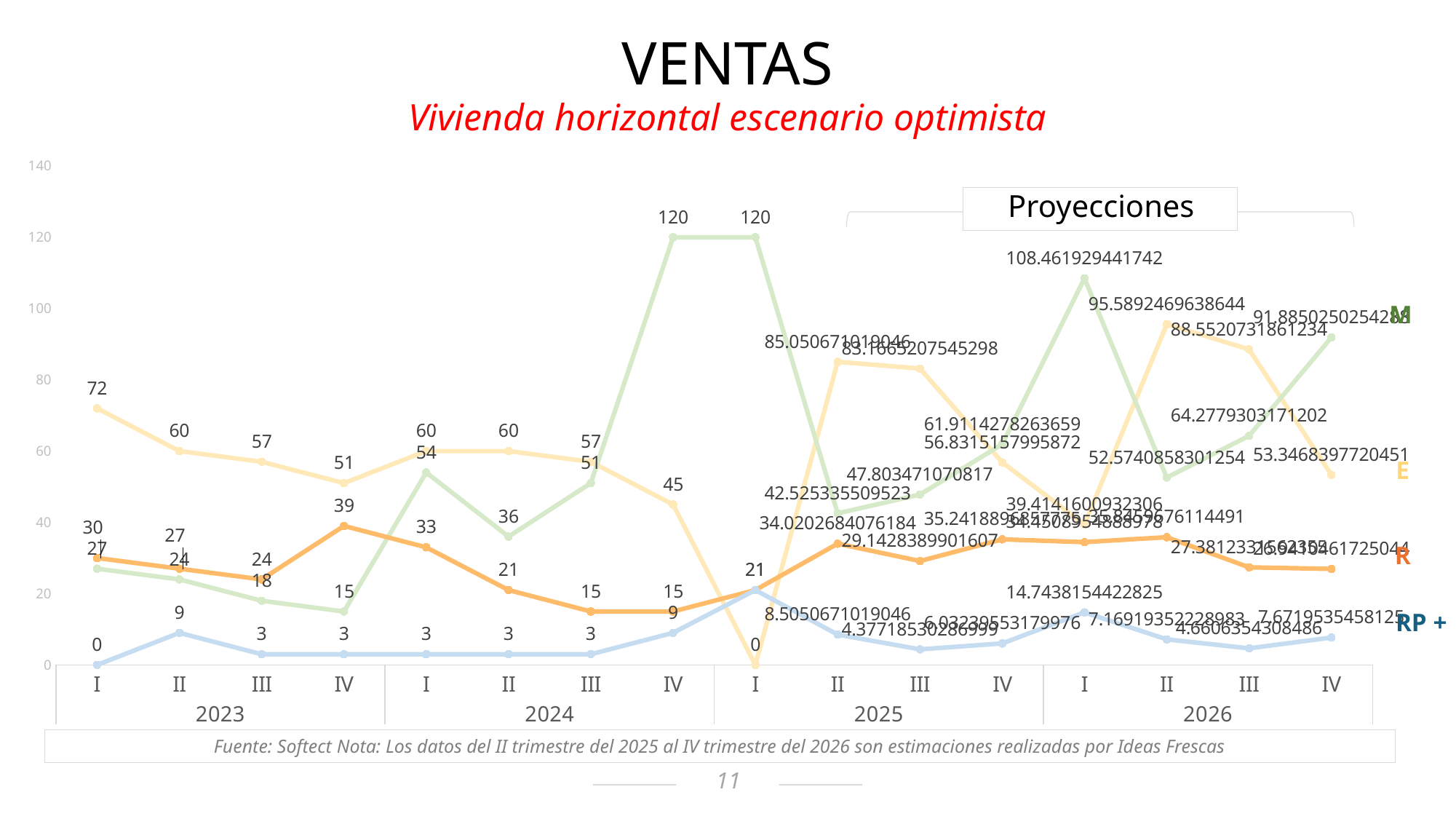
What kind of chart is shown on the slide? line chart How many series are plotted in the chart? 4 What is the difference between series E and series M in quarter I of 2023? 45 What is the value of series RP + in quarter II of 2023? 9 Does series E rise or fall from quarter I to quarter IV of 2023? fall How many quarterly points are plotted along the x axis? 16 In quarter I of 2024, which is larger: series M or series E? E What is the value of series E in quarter I of 2023? 72 What is the value of series R in quarter IV of 2023? 39 What is the red subtitle of the chart? Vivienda horizontal escenario optimista Is the value for series M in quarter I of 2026 greater or less than 100? greater What is the value of series M in quarter IV of 2024? 120